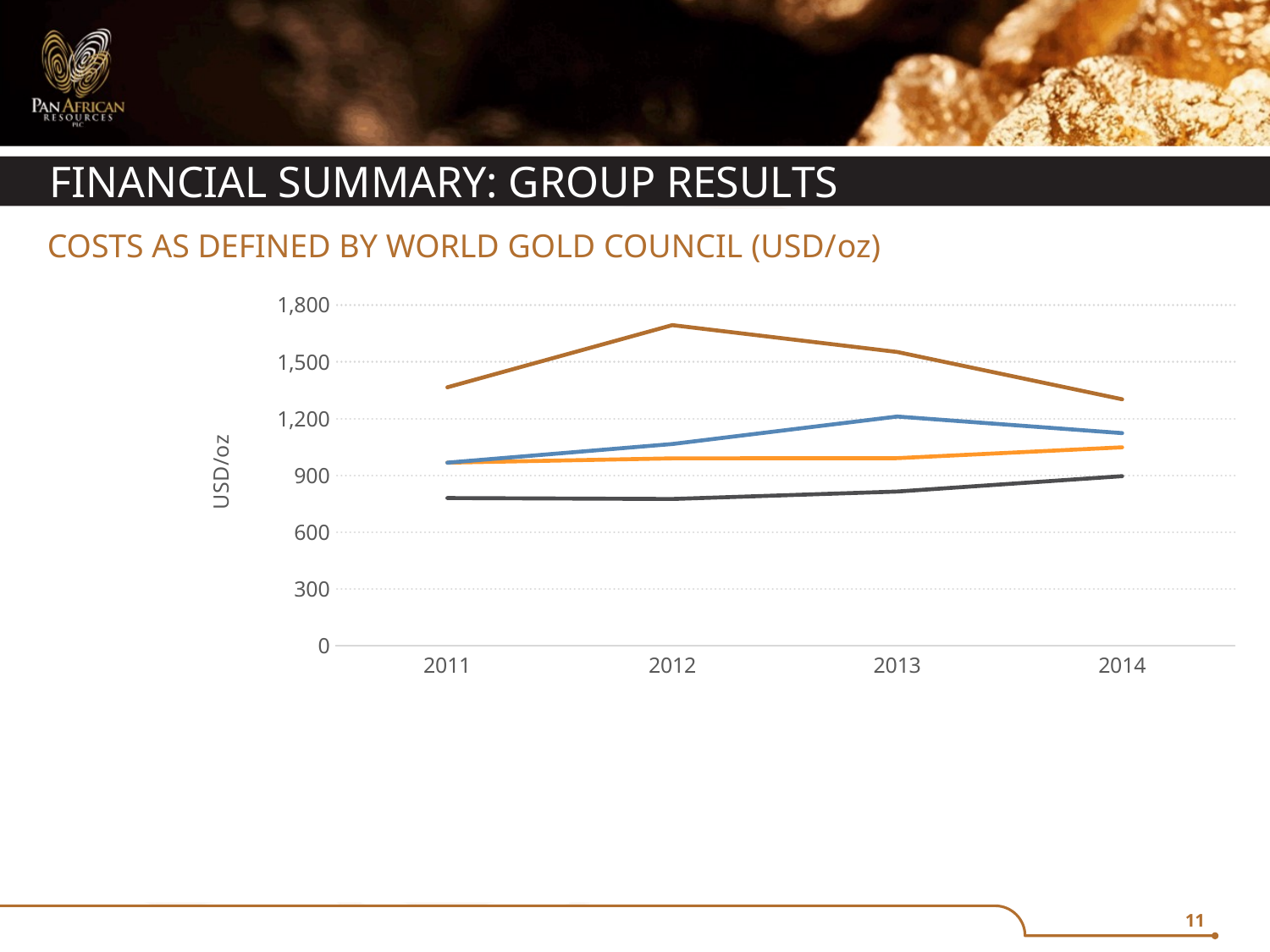
In which year does the blue line reach its highest value? 2013 Is the value of the dark grey line in 2013 greater or less than 900? less What kind of chart is shown on the slide? line chart Does the brown line rise or fall from 2012 to 2014? fall How many years are shown on the x axis of the chart? 4 In which year does the brown line reach its highest value? 2012 How many lines are plotted on the chart? 4 What is the title of the chart? COSTS AS DEFINED BY WORLD GOLD COUNCIL (USD/oz) What is the label on the vertical axis of the chart? USD/oz Is the value of the brown line in 2012 greater or less than 1,500? greater Is the value of the orange line in 2014 greater or less than 900? greater In 2011, which line has the higher value, the brown line or the blue line? brown line